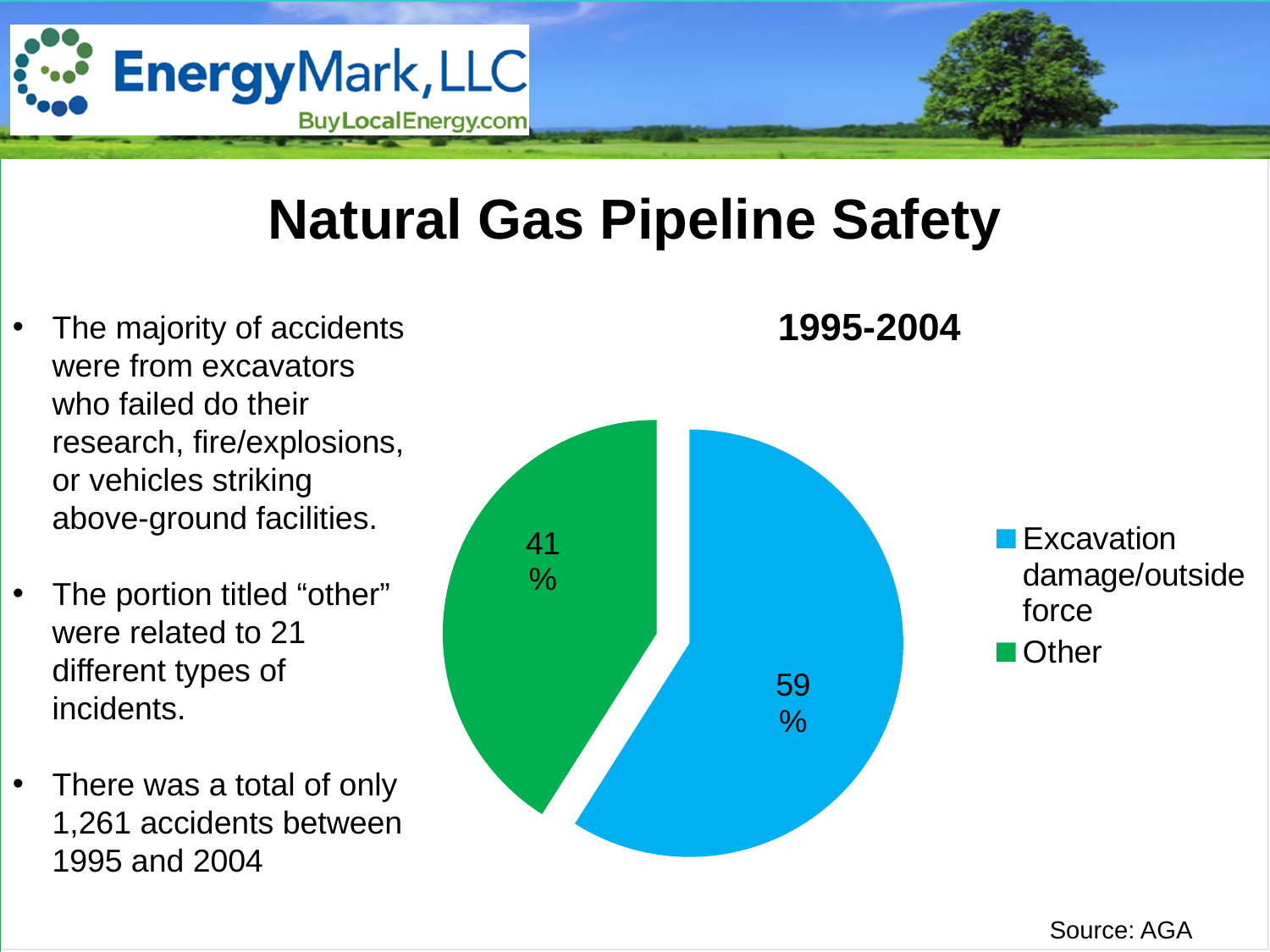
Which slice of the pie is the smallest? Other What type of chart is shown on the slide? pie chart What is the difference in percentage points between the "Excavation damage/outside force" slice and the "Other" slice? 18 What is the title of the chart? 1995-2004 How many slices does the pie chart have? 2 Which is larger: the "Other" slice or the "Excavation damage/outside force" slice? Excavation damage/outside force What colour is the "Other" slice of the pie? green What share of the pie is labelled "Excavation damage/outside force"? 59% Which slice of the pie is the largest? Excavation damage/outside force How many entries does the legend list? 2 What share of the pie is labelled "Other"? 41%